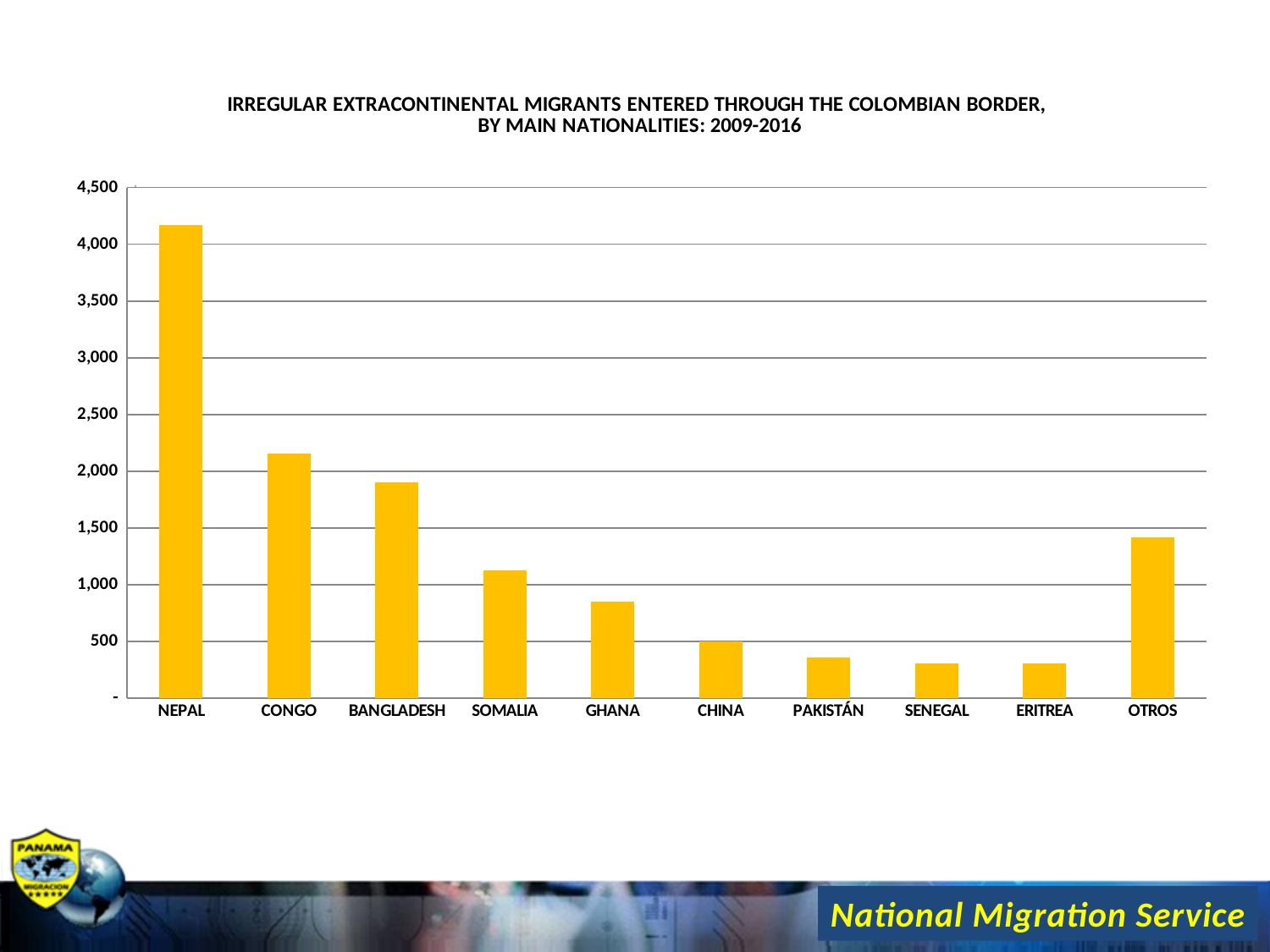
Is the value for PAKISTÁN greater or less than 500? less Is the value for SOMALIA greater or less than 1,000? greater Is the value for CONGO greater or less than 2,000? greater What period does the chart title say the data covers? 2009-2016 Which nationality has the highest number of irregular extracontinental migrants? NEPAL Which is larger, the value for GHANA or the value for CHINA? GHANA What kind of chart is shown on the slide? Bar chart How many nationality categories are shown on the x axis? 10 Which is larger, the value for CONGO or the value for BANGLADESH? CONGO